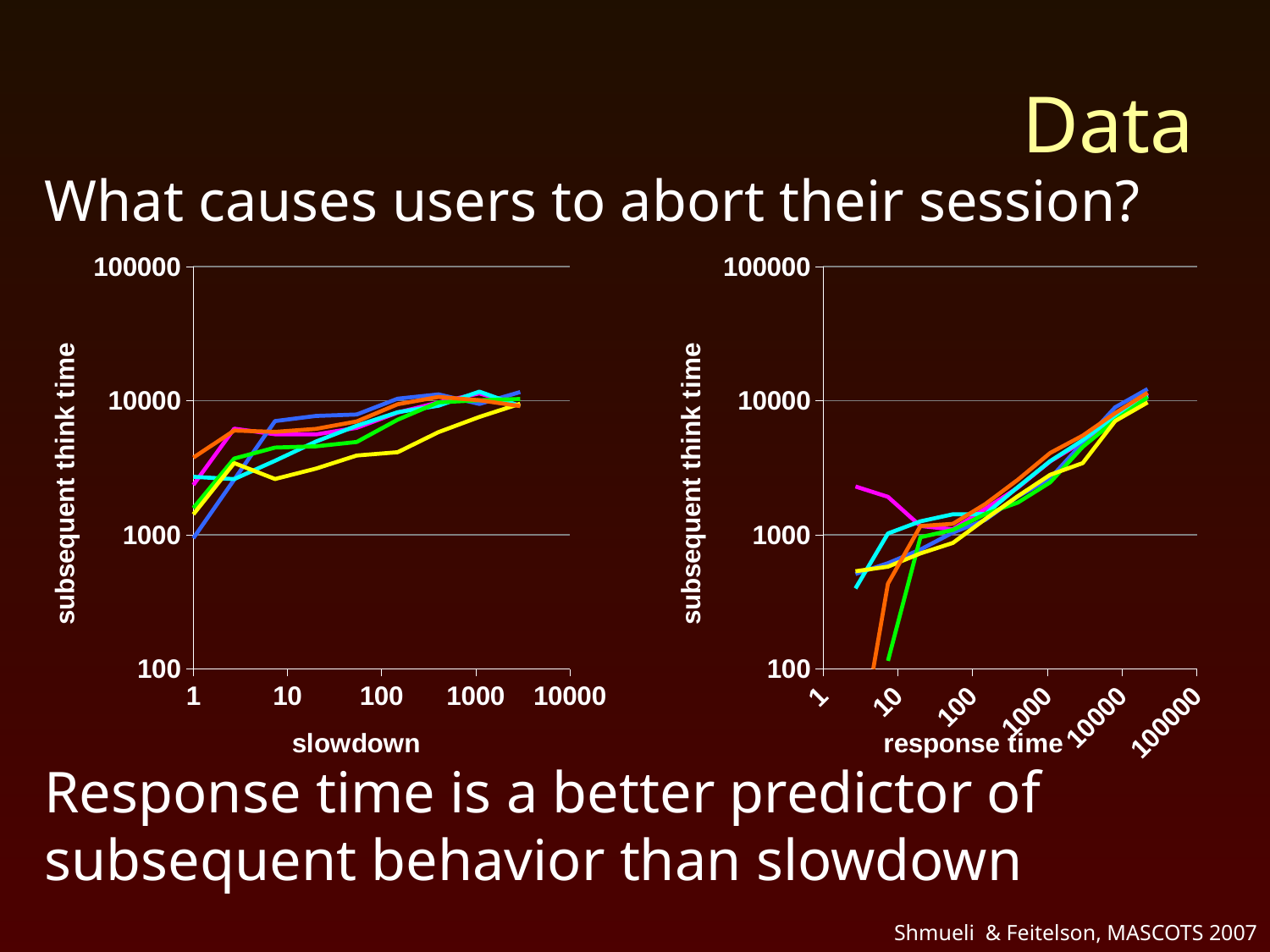
What is the x-axis label of the right chart? response time In the left chart (x axis 'slowdown'), are the values of the lines at slowdown 1000 greater or less than 1000? greater What kind of chart is the left chart, with x axis 'slowdown'? line chart In the left chart (x axis 'slowdown'), are the values of the lines at slowdown 1 greater or less than 10000? less In the right chart (x axis 'response time'), is the value of the green line at response time 10 greater or less than 1000? less What kind of chart is the right chart, with x axis 'response time'? line chart In the left chart (x axis 'slowdown'), do the lines generally rise or fall as slowdown increases? rise What is the y-axis label of the left chart? subsequent think time In the right chart (x axis 'response time'), do the lines generally rise or fall as response time increases? rise